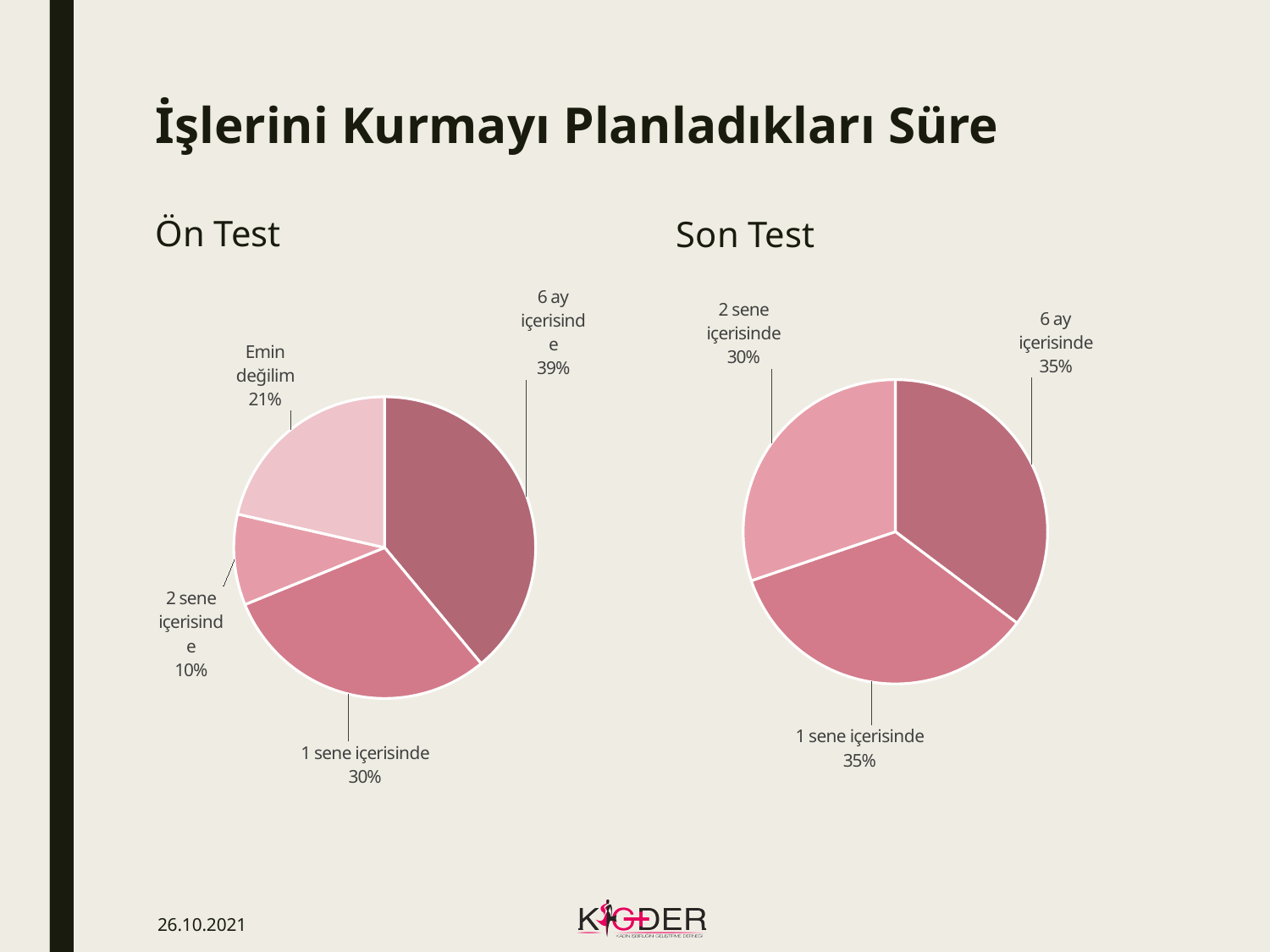
In the Son Test pie chart, which category has the smallest slice? 2 sene içerisinde In the Ön Test pie chart, what share is labelled for "6 ay içerisinde"? 39% In the Ön Test pie chart, which category has the largest slice? 6 ay içerisinde In the Ön Test pie chart, what share is labelled for "2 sene içerisinde"? 10% In the Ön Test pie chart, which category has the smallest slice? 2 sene içerisinde What type of chart is used for the Ön Test data? Pie chart In the Ön Test pie chart, what is the difference between the "1 sene içerisinde" and "2 sene içerisinde" shares? 20% In the Son Test pie chart, what share is labelled for "1 sene içerisinde"? 35% In the Son Test pie chart, what share is labelled for "2 sene içerisinde"? 30% How many slices does the Son Test pie chart have? 3 In the Ön Test pie chart, what share is labelled for "Emin değilim"? 21% What is the difference between the "6 ay içerisinde" share in the Ön Test chart and the "6 ay içerisinde" share in the Son Test chart? 4%